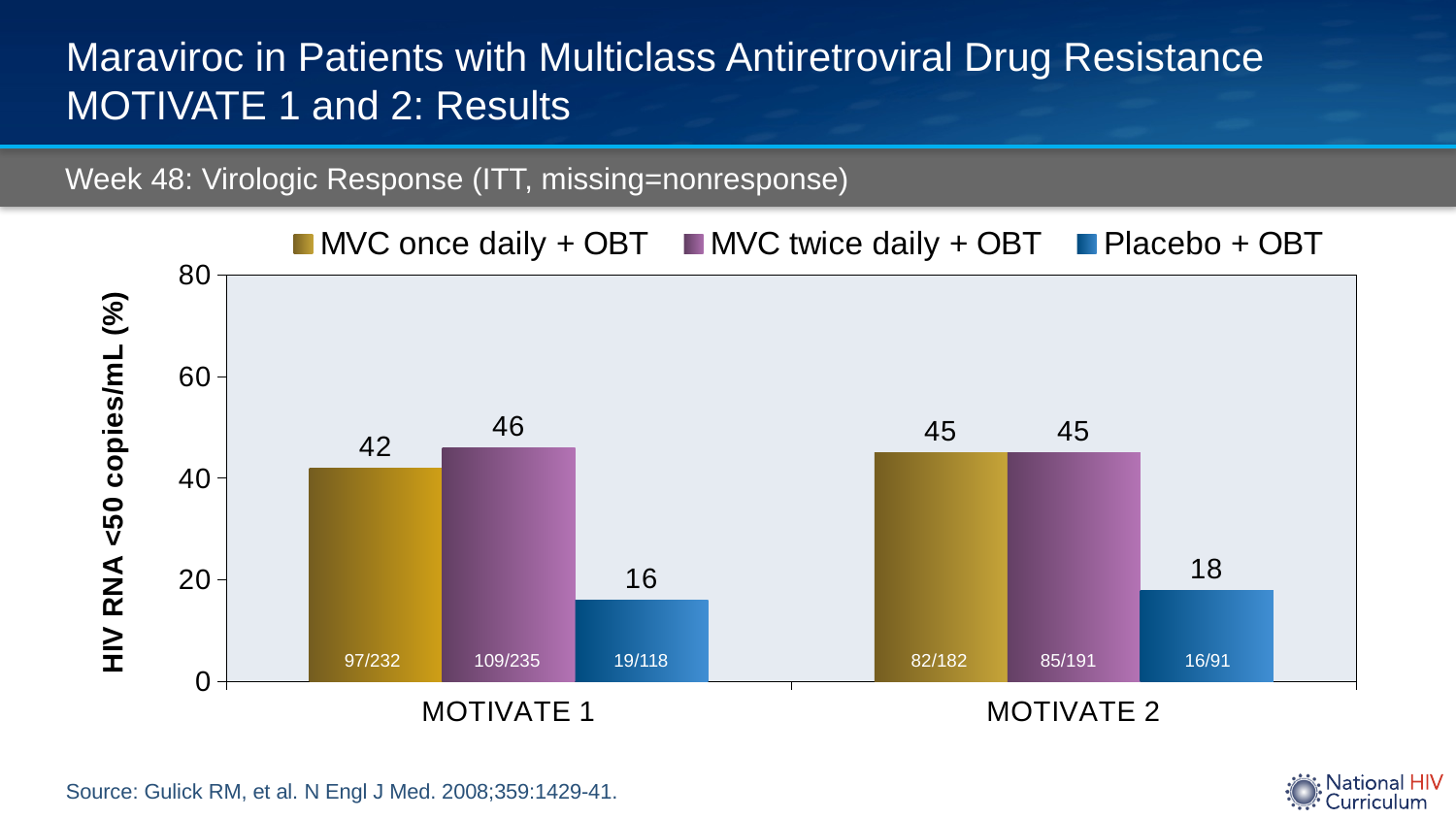
How many series does the legend list? 3 What is the difference between MVC once daily + OBT in MOTIVATE 2 and MOTIVATE 1? 3 What is the y-axis label of the chart? HIV RNA <50 copies/mL (%) Which series has the lowest value in MOTIVATE 2? Placebo + OBT What is the value for MVC twice daily + OBT in MOTIVATE 1? 46 What kind of chart is shown on the slide? Bar chart How many categories are shown on the x axis? 2 What is the difference between MVC twice daily + OBT and Placebo + OBT in MOTIVATE 1? 30 Which series has the highest value in MOTIVATE 1? MVC twice daily + OBT Which is larger: Placebo + OBT in MOTIVATE 1 or Placebo + OBT in MOTIVATE 2? Placebo + OBT in MOTIVATE 2 What is the value for MVC once daily + OBT in MOTIVATE 1? 42 What is the value for Placebo + OBT in MOTIVATE 2? 18